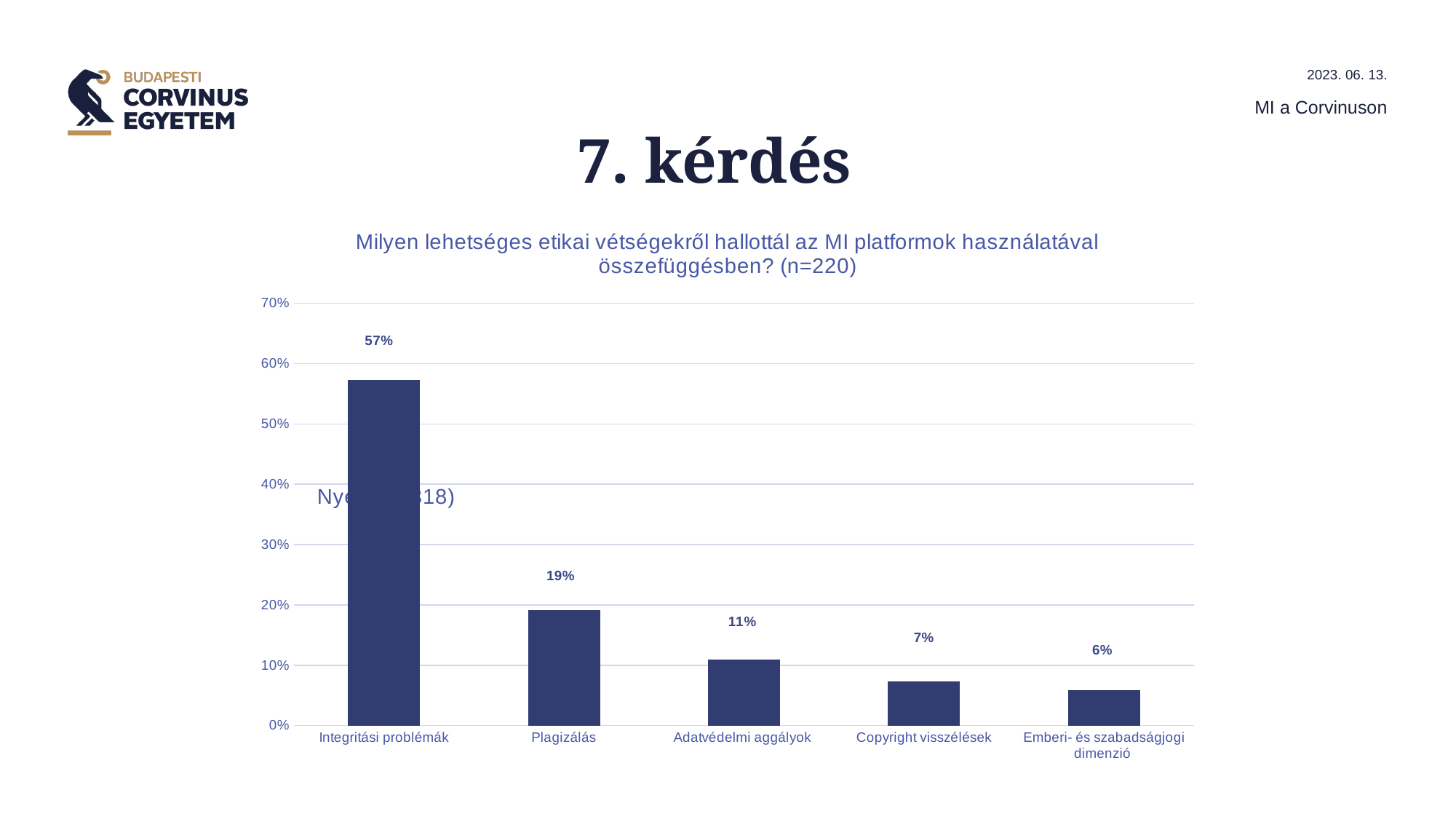
What is the value for Adatvédelmi aggályok? 11% What is the value for Copyright visszélések? 7% Which category has the highest value? Integritási problémák What is the value for Integritási problémák? 57% Which is larger, the value for Plagizálás or the value for Adatvédelmi aggályok? Plagizálás Is the value for Integritási problémák greater or less than 50%? greater How many categories are shown on the x axis? 5 What is the difference between the values for Integritási problémák and Plagizálás? 38% What is the value for Plagizálás? 19% What is the value for Emberi- és szabadságjogi dimenzió? 6% What kind of chart is shown on the slide? bar chart Which category has the lowest value? Emberi- és szabadságjogi dimenzió